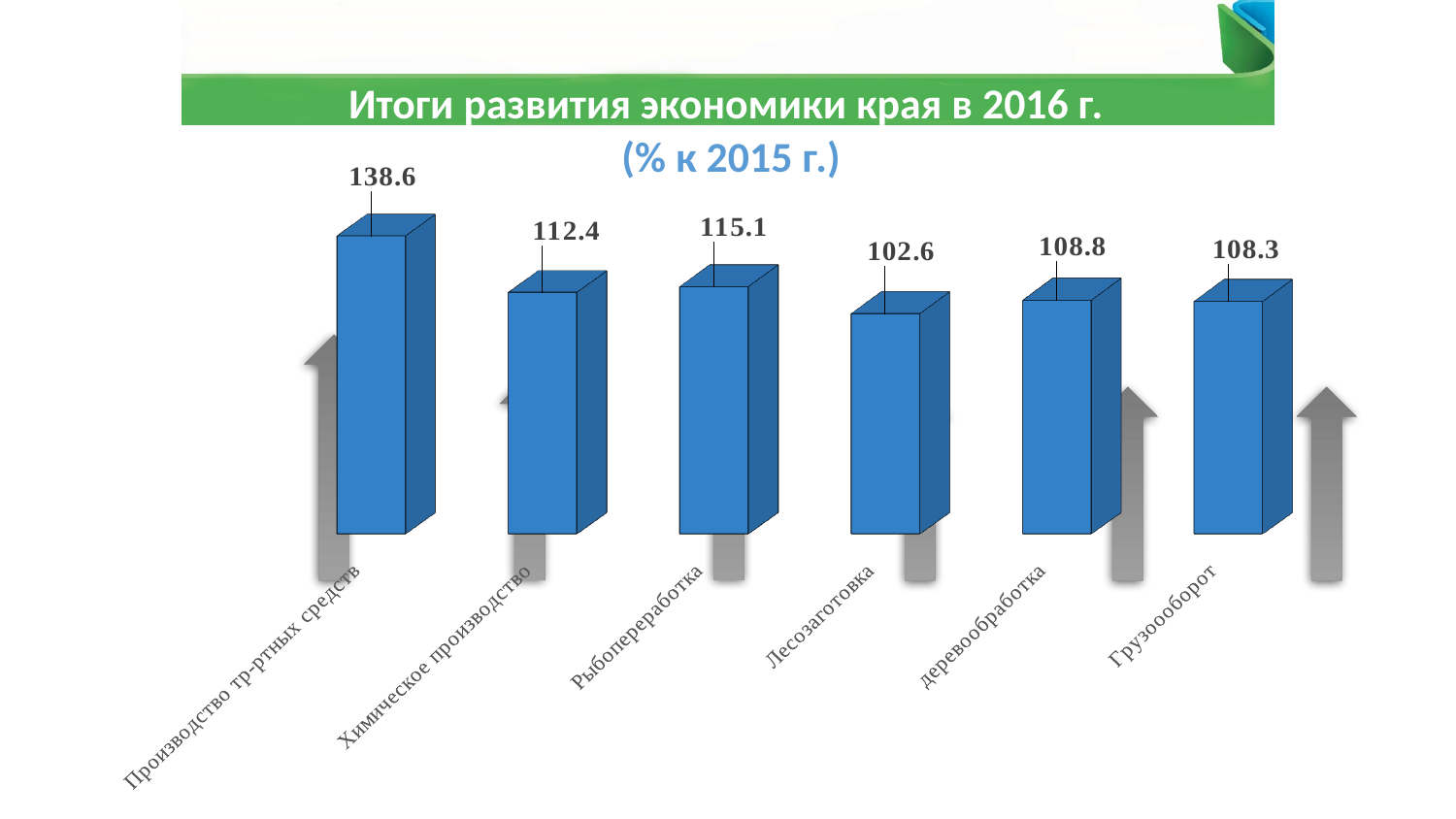
What is the value for Производство тр-ртных средств? 138.6 Which category has the lowest value? Лесозаготовка Which category has the highest value? Производство тр-ртных средств What is the value for Рыбопереработка? 115.1 What kind of chart is shown on the slide? Bar chart What is the difference between the values for Рыбопереработка and Химическое производство? 2.7 What is the value for Лесозаготовка? 102.6 What is the value for Грузооборот? 108.3 Which is larger, the value for Рыбопереработка or the value for деревообработка? Рыбопереработка What is the value for Химическое производство? 112.4 What is the difference between the values for Производство тр-ртных средств and Лесозаготовка? 36.0 How many categories are shown in the chart? 6